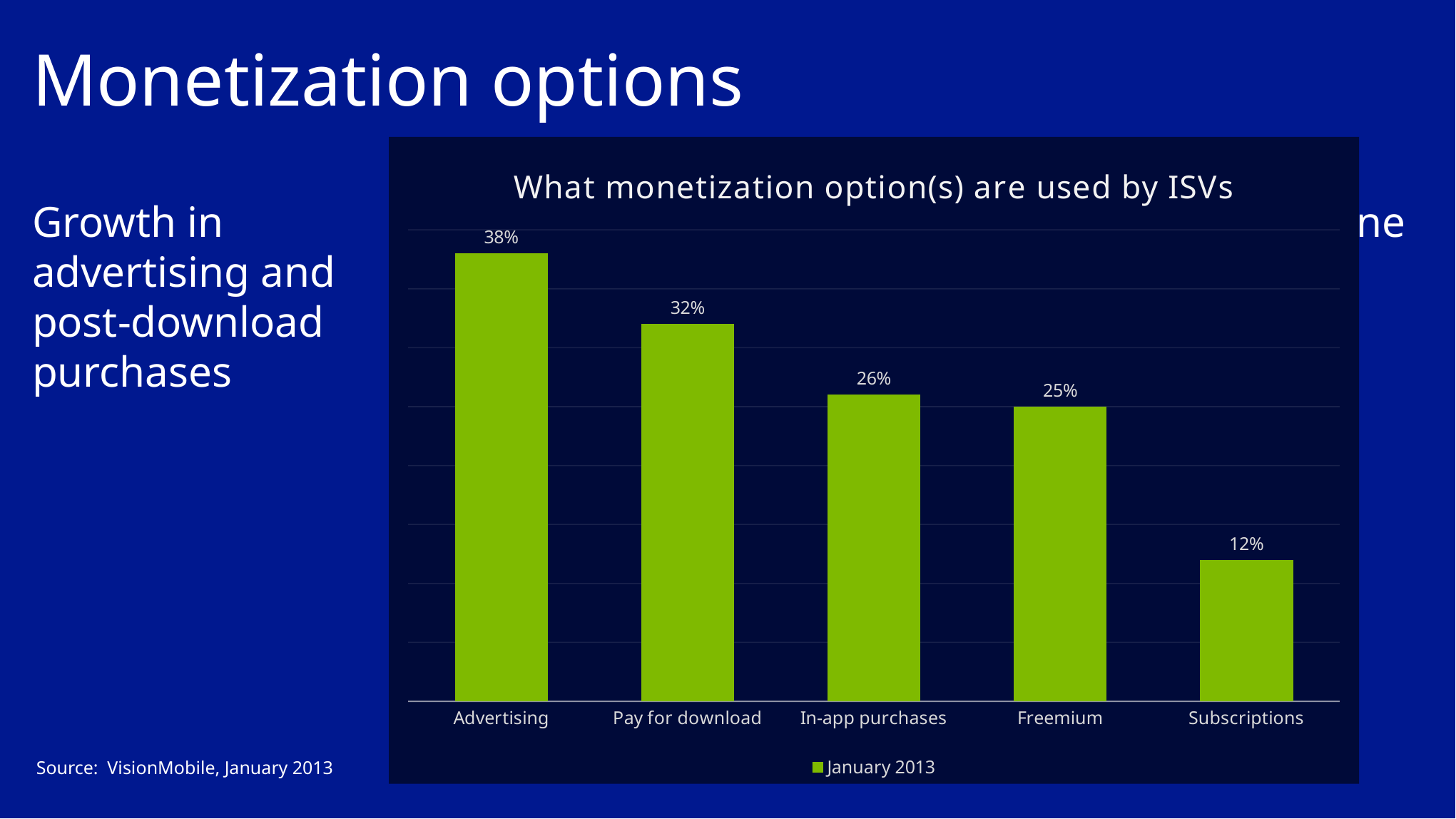
Which monetization option has the highest value? Advertising What is the difference between the values for Pay for download and Freemium? 7% What is the difference between the values for Advertising and Subscriptions? 26% How many monetization options are shown on the x axis? 5 What is the value shown for Pay for download? 32% Which is larger, the value for Pay for download or the value for In-app purchases? Pay for download What percentage of ISVs use Advertising as a monetization option? 38% What series does the legend list? January 2013 What is the value shown for In-app purchases? 26% What is the value shown for Subscriptions? 12% Which monetization option has the lowest value? Subscriptions What type of chart is shown on the slide? Bar chart